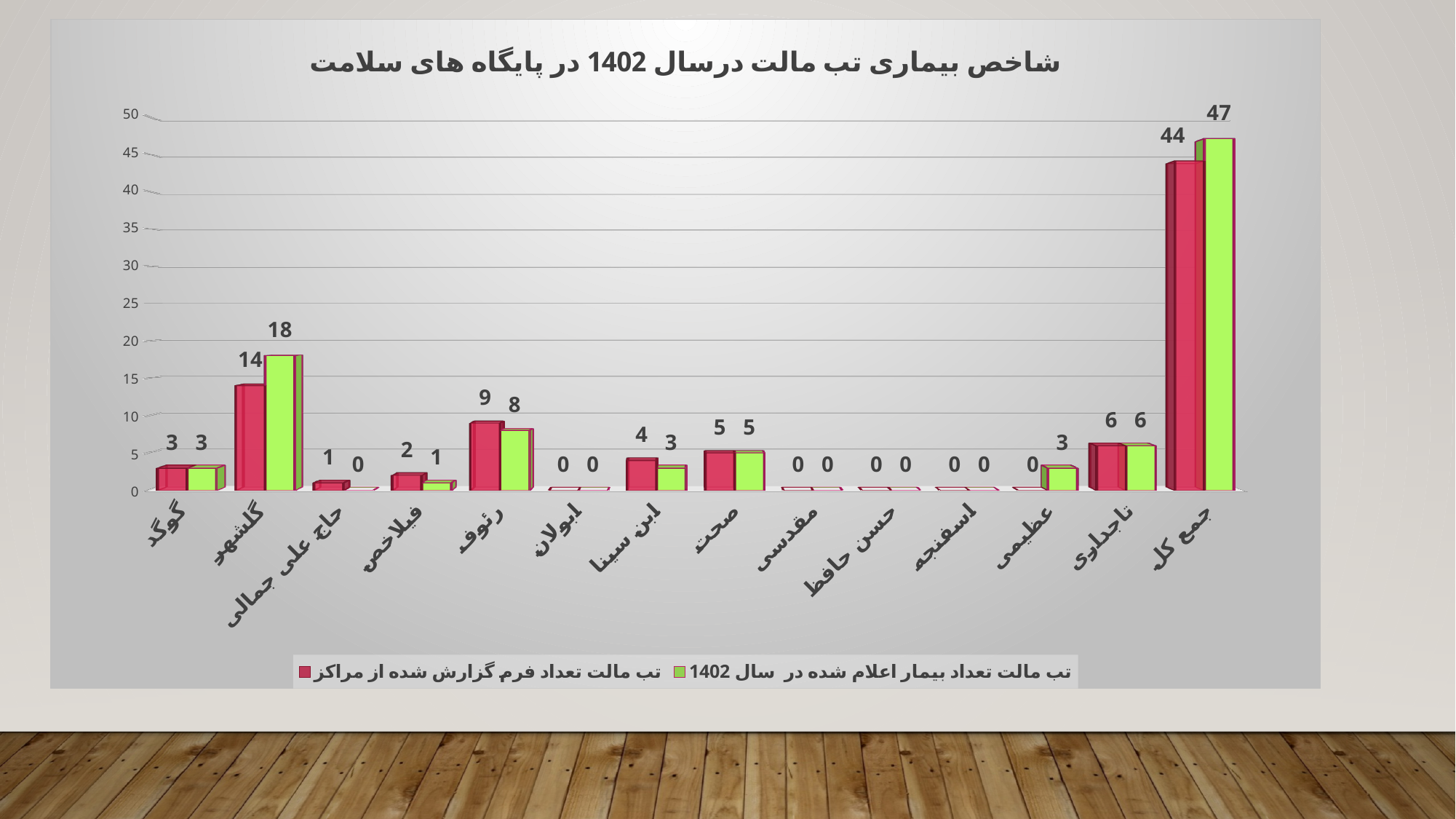
What is the title of the chart? شاخص بیماری تب مالت درسال 1402 در پایگاه های سلامت What is the value of the green bar for عظیمی? 3 How many series does the legend list? 2 What kind of chart is shown on the slide? bar chart What is the value of the green bar for گلشهر? 18 What is the value of the green bar for جمع کل? 47 Which is larger for ابن سینا, the red bar or the green bar? the red bar What is the difference between the green and red bars for گلشهر? 4 What is the value of the red bar for رئوف? 9 How many categories are shown along the x axis? 14 Excluding جمع کل, which category has the highest red bar? گلشهر What is the value of the red bar for جمع کل? 44